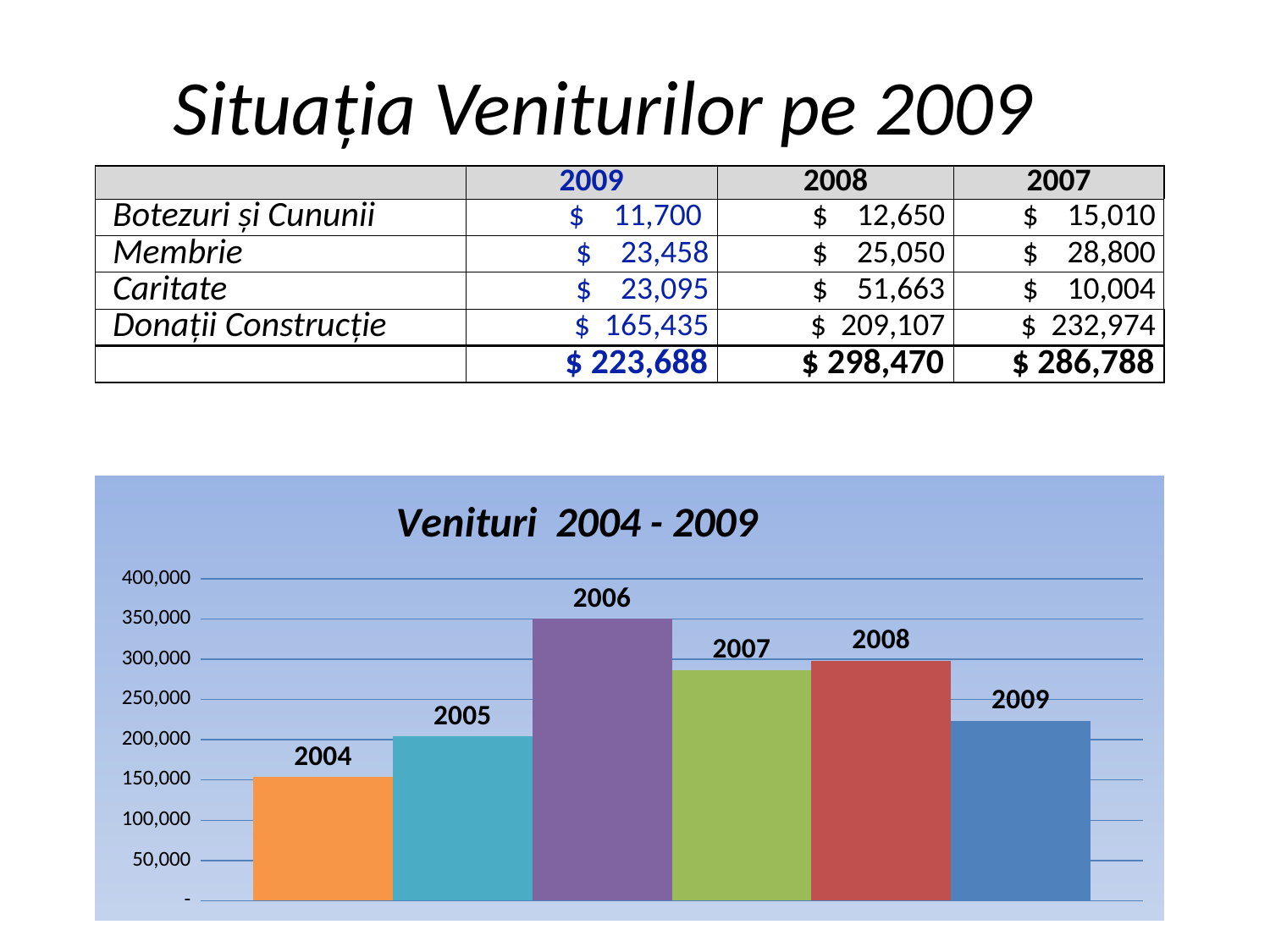
Which year has the highest bar in the "Venituri 2004 - 2009" chart? 2006 In the "Venituri 2004 - 2009" chart, is the value for 2006 greater or less than 300,000? greater What kind of chart is shown under the title "Venituri 2004 - 2009"? bar chart In the "Venituri 2004 - 2009" chart, is the value for 2009 greater or less than 250,000? less How many bars (years) are plotted in the "Venituri 2004 - 2009" chart? 6 In the "Venituri 2004 - 2009" chart, is the value for 2008 greater or less than 250,000? greater In the "Venituri 2004 - 2009" chart, which is larger, the value for 2006 or the value for 2009? 2006 What is the title of the chart on the slide? Venituri 2004 - 2009 Which year has the lowest bar in the "Venituri 2004 - 2009" chart? 2004 In the "Venituri 2004 - 2009" chart, do the values rise or fall from 2006 to 2009? fall